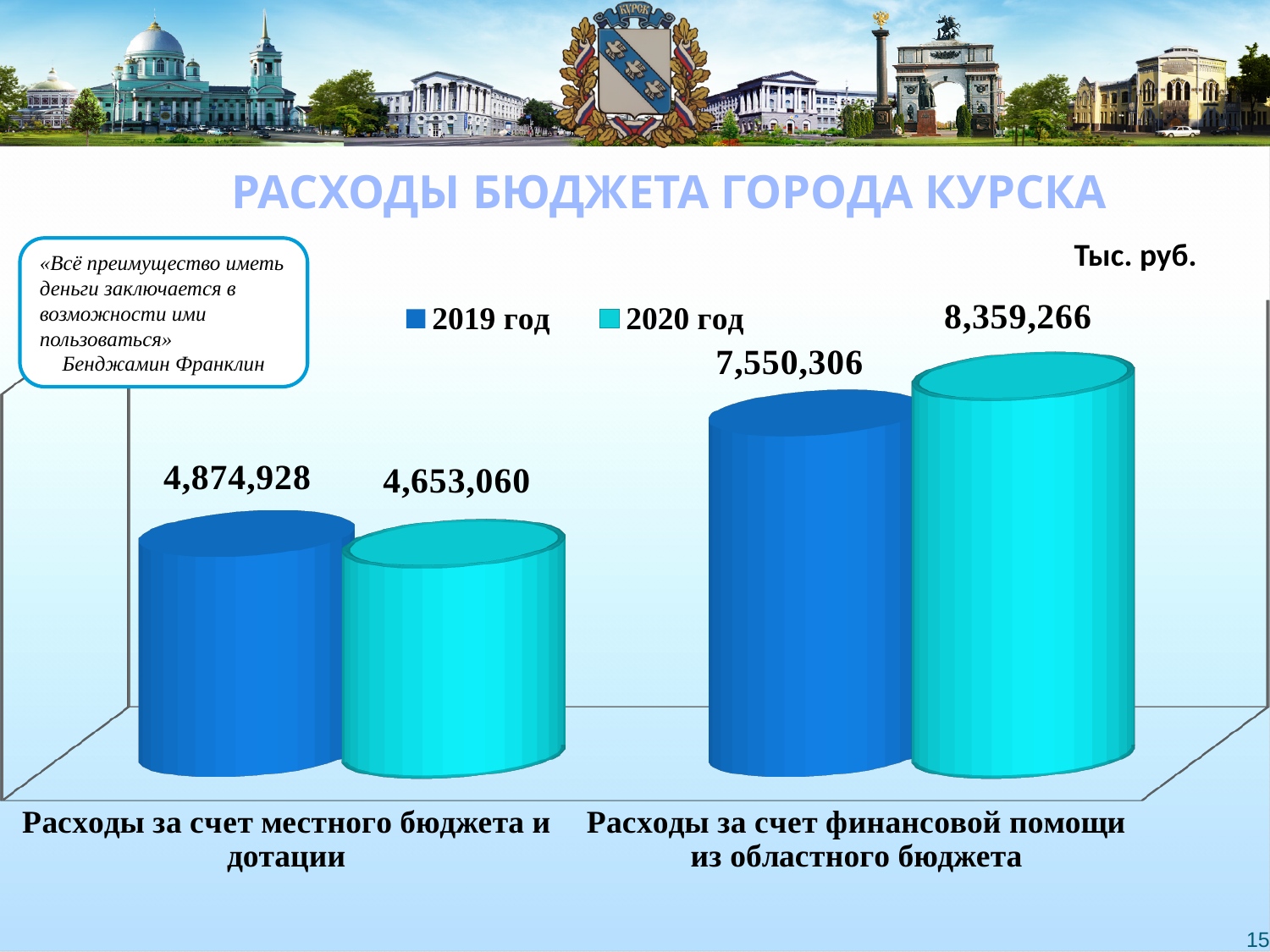
Which bar has the lowest value on the chart? 2020 год, Расходы за счет местного бюджета и дотации What is the difference between the 2019 год and 2020 год values for «Расходы за счет местного бюджета и дотации»? 221,868 For «Расходы за счет местного бюджета и дотации», which year has the larger value, 2019 год or 2020 год? 2019 год Which bar has the highest value on the chart? 2020 год, Расходы за счет финансовой помощи из областного бюджета What is the value for 2019 год in the category «Расходы за счет местного бюджета и дотации»? 4,874,928 What is the value for 2020 год in the category «Расходы за счет финансовой помощи из областного бюджета»? 8,359,266 What unit of measurement is indicated for the chart values? Тыс. руб. What is the difference between the 2020 год and 2019 год values for «Расходы за счет финансовой помощи из областного бюджета»? 808,960 How many series does the legend list? 2 How many categories are shown on the x axis? 2 What is the value for 2020 год in the category «Расходы за счет местного бюджета и дотации»? 4,653,060 What is the value for 2019 год in the category «Расходы за счет финансовой помощи из областного бюджета»? 7,550,306